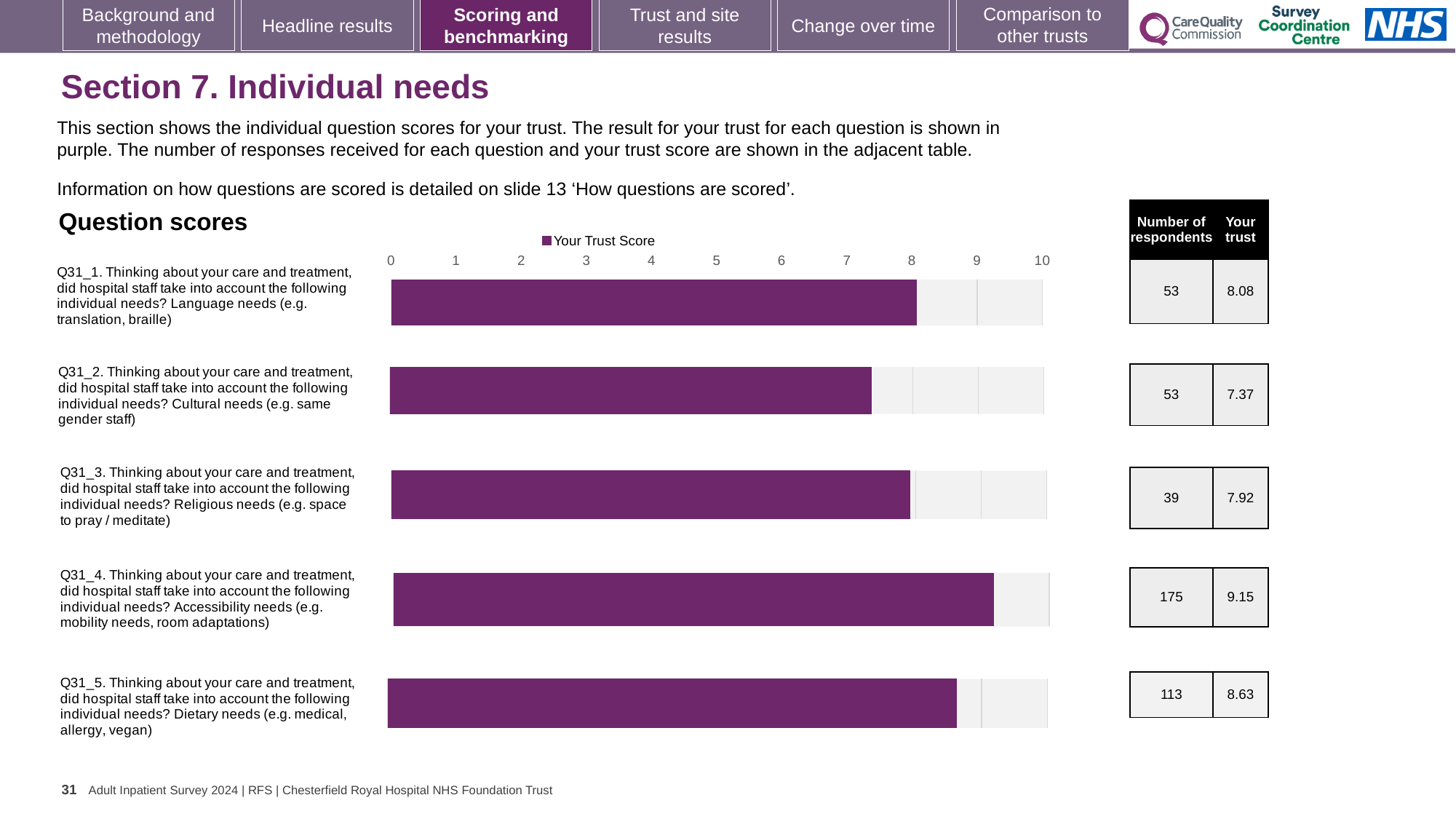
Which has the larger trust score, Q31_3 (Religious needs) or Q31_5 (Dietary needs)? Q31_5 (Dietary needs) Which question has the highest trust score? Q31_4 (Accessibility needs) How many series does the chart legend list? 1 What is the name of the series shown in the chart legend? Your Trust Score How many questions are plotted in the chart? 5 Is the trust score for Q31_2 (Cultural needs) greater or less than 8? less How many respondents answered Q31_5 (Dietary needs)? 113 Which question has the lowest trust score? Q31_2 (Cultural needs) What kind of chart is shown on the slide? Bar chart What is the trust score for Q31_1 (Language needs)? 8.08 What is the difference between the trust scores for Q31_4 and Q31_2? 1.78 What is the trust score for Q31_4 (Accessibility needs)? 9.15